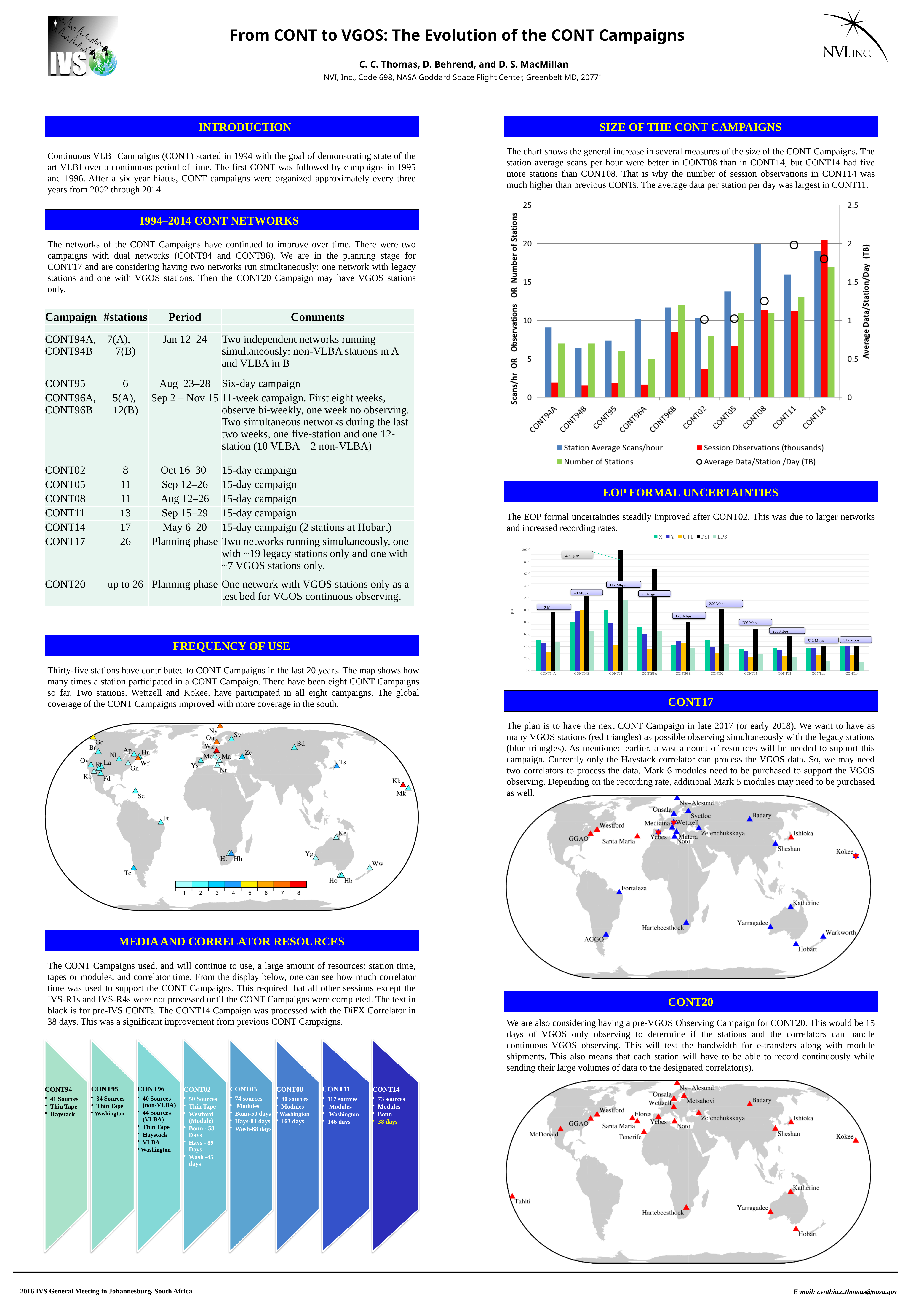
In the 'Size of the CONT Campaigns' chart, is the Session Observations (thousands) value for CONT02 greater or less than 5? less In the 'Size of the CONT Campaigns' chart, does the Number of Stations rise or fall from CONT02 to CONT14? rise In the 'Size of the CONT Campaigns' chart, which campaign has the highest Session Observations (thousands)? CONT14 In the 'EOP Formal Uncertainties' chart, what is the annotated PSI value for CONT95? 251 µas In the 'Size of the CONT Campaigns' chart, is the Average Data/Station/Day (TB) for CONT11 greater or less than 1.5? greater In the 'Size of the CONT Campaigns' chart, how many series does the legend list? 4 In the 'EOP Formal Uncertainties' chart, how many series does the legend list? 5 In the 'Size of the CONT Campaigns' chart, which has the larger Number of Stations, CONT96B or CONT02? CONT96B In the 'Size of the CONT Campaigns' chart, is the Station Average Scans/hour for CONT08 greater or less than 15? greater In the 'Size of the CONT Campaigns' chart, how many campaigns are shown on the x axis? 10 What kind of chart is the 'EOP Formal Uncertainties' chart? bar chart In the 'Size of the CONT Campaigns' chart, which campaign has the highest Number of Stations? CONT14